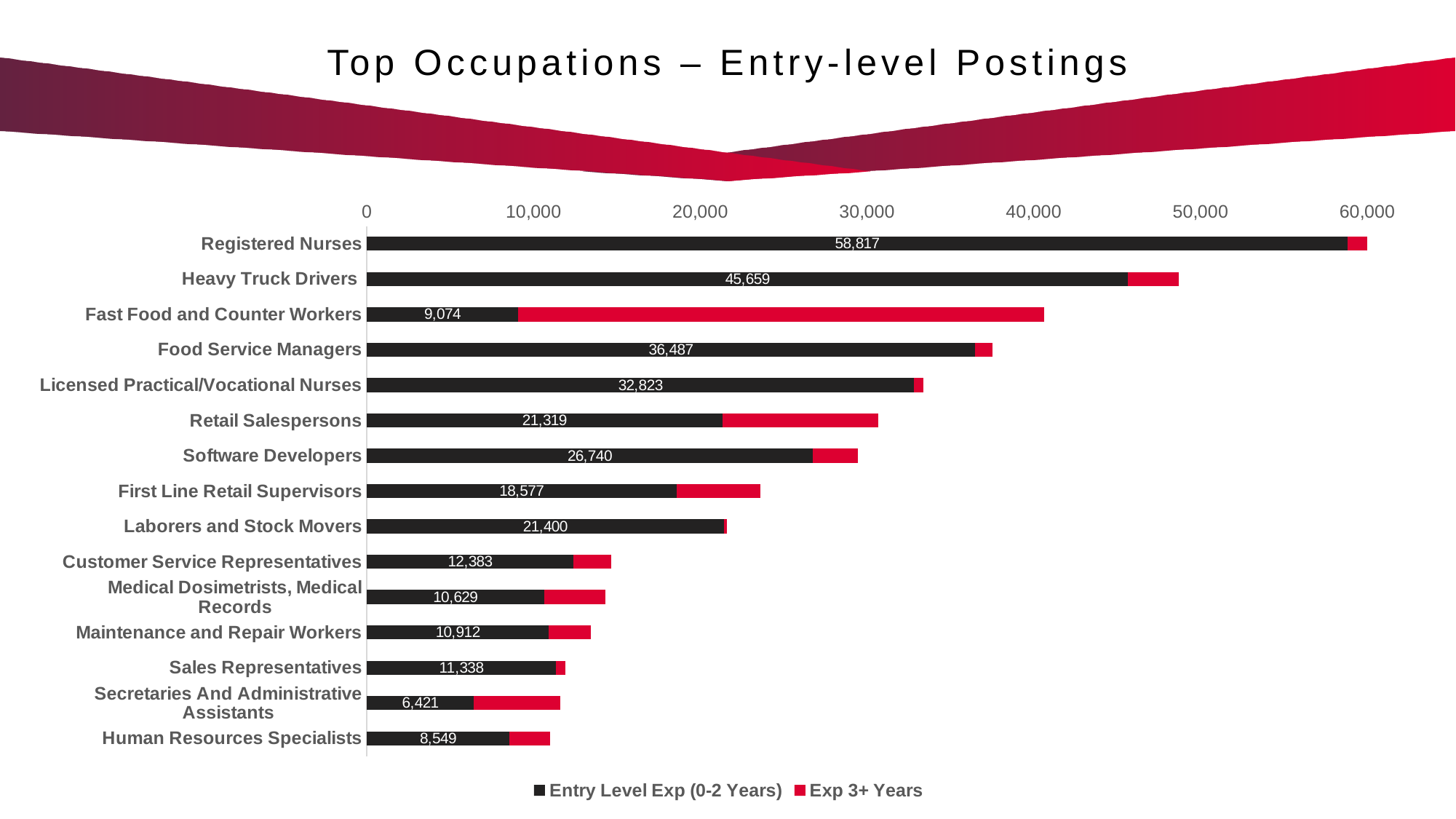
What is the difference between the Entry Level Exp (0-2 Years) values for Registered Nurses and Heavy Truck Drivers? 13,158 What is the Entry Level Exp (0-2 Years) value for Registered Nurses? 58,817 Is the total bar length for Heavy Truck Drivers greater or less than 50,000? less Which occupation has the lowest Entry Level Exp (0-2 Years) value? Secretaries And Administrative Assistants What is the Entry Level Exp (0-2 Years) value for Fast Food and Counter Workers? 9,074 How many series does the legend list? 2 Which has the larger Entry Level Exp (0-2 Years) value, Maintenance and Repair Workers or Medical Dosimetrists, Medical Records? Maintenance and Repair Workers How many occupations are shown in the chart? 15 Which occupation has the highest Entry Level Exp (0-2 Years) value? Registered Nurses What type of chart is shown on the slide? Stacked bar chart Is the total bar length for First Line Retail Supervisors greater or less than 20,000? greater What is the Entry Level Exp (0-2 Years) value for Software Developers? 26,740